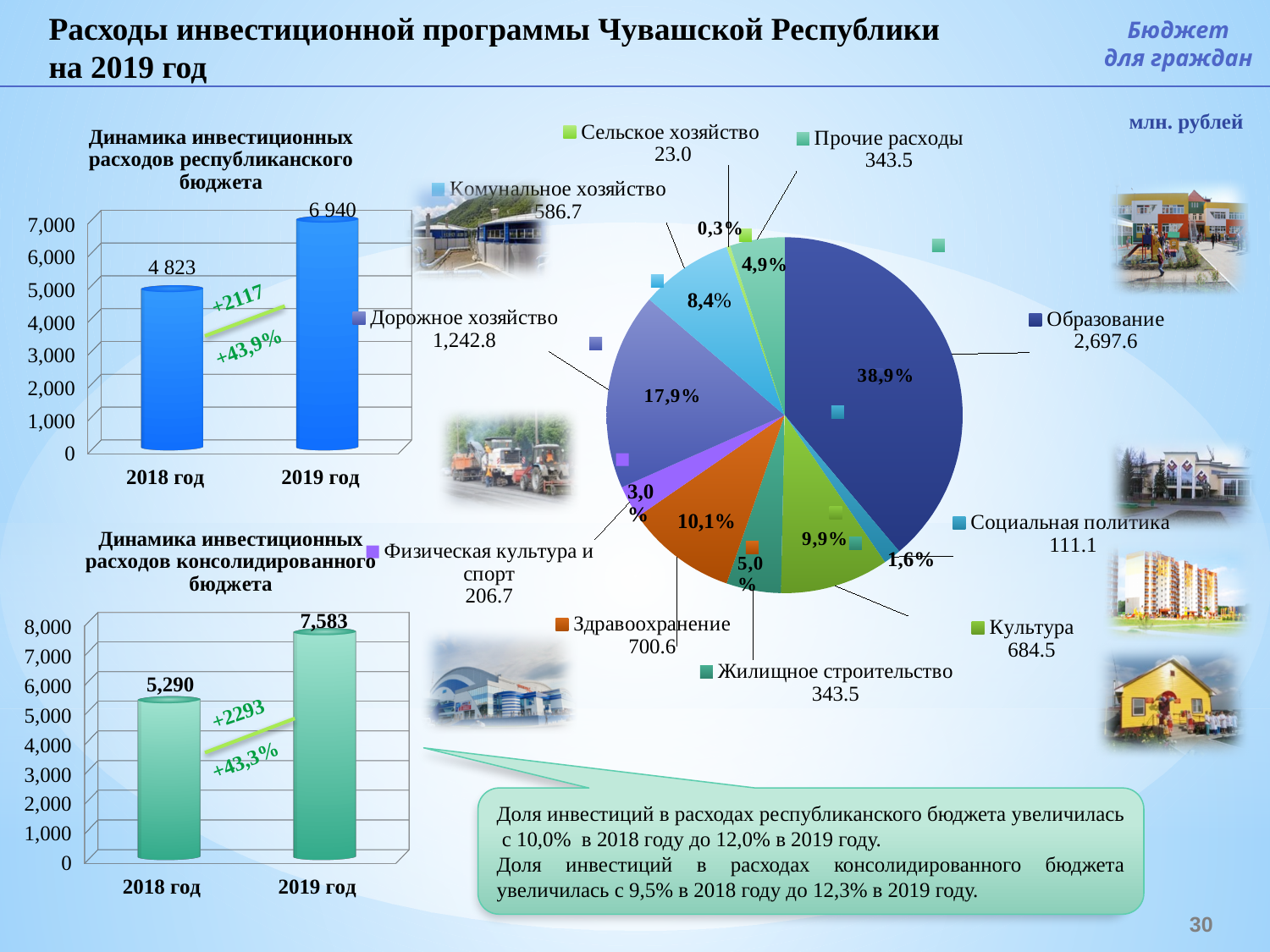
In the chart 'Динамика инвестиционных расходов консолидированного бюджета', do the values rise or fall from 2018 год to 2019 год? rise In the chart 'Динамика инвестиционных расходов консолидированного бюджета', what is the value for 2019 год? 7,583 In the pie chart, what share does Дорожное хозяйство have? 17,9% How many categories does the pie chart show? 10 What kind of chart is 'Динамика инвестиционных расходов республиканского бюджета'? bar chart In the pie chart, which category has the smallest slice? Сельское хозяйство In the pie chart, what is the value for Образование? 2,697.6 In the pie chart, which is larger: Здравоохранение or Культура? Здравоохранение In the chart 'Динамика инвестиционных расходов республиканского бюджета', what is the value for 2018 год? 4 823 In the chart 'Динамика инвестиционных расходов консолидированного бюджета', what is the difference between the 2019 год and 2018 год values? 2293 In the pie chart, which category has the largest slice? Образование In the chart 'Динамика инвестиционных расходов республиканского бюджета', what is the value for 2019 год? 6 940